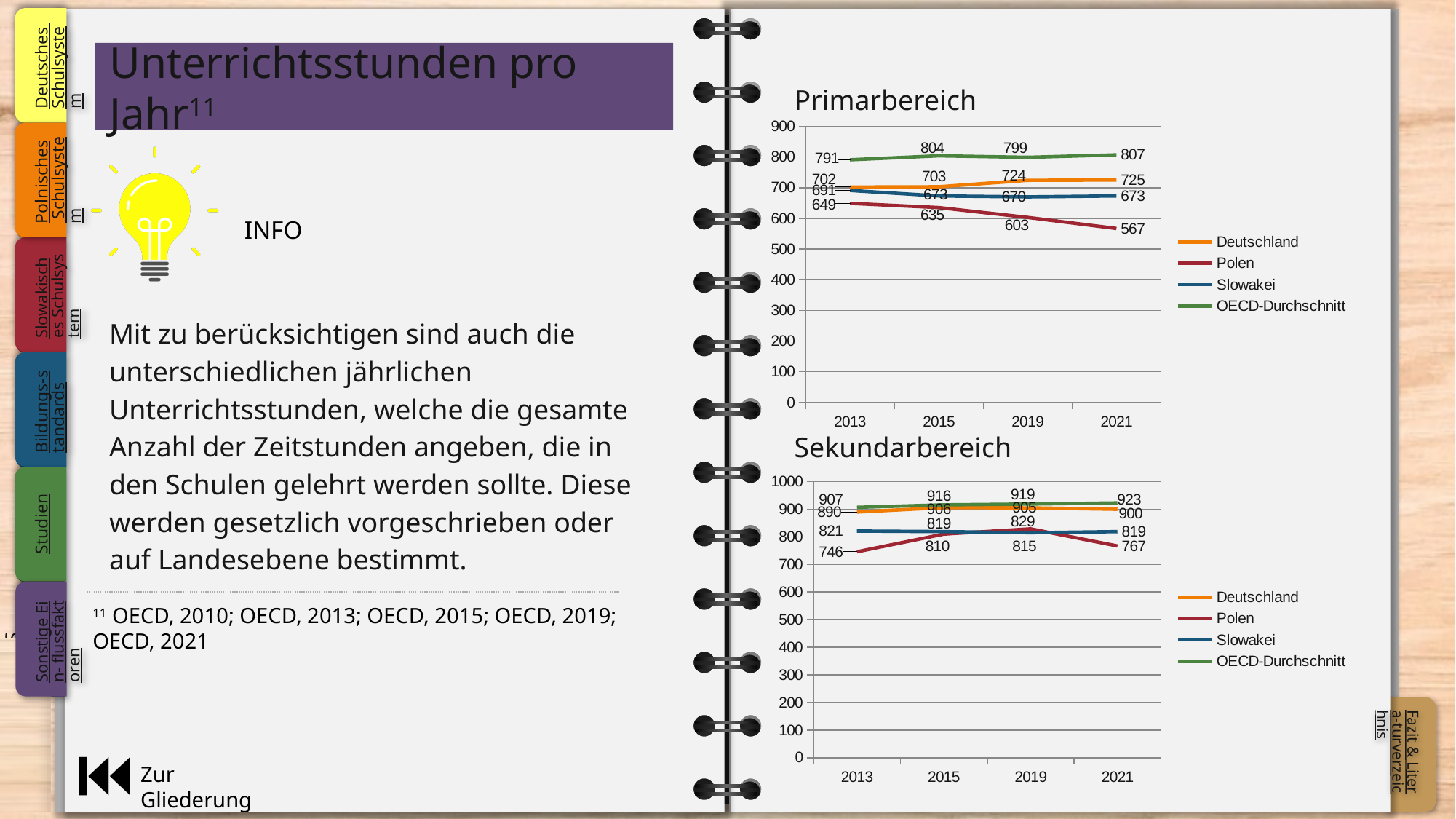
In the Sekundarbereich chart, what is the value for Polen in 2019? 829 In the Primarbereich chart, do the values for Polen rise or fall from 2013 to 2021? fall In the Primarbereich chart, what is the value for Polen in 2021? 567 In the Primarbereich chart, which series has the lowest value in 2021? Polen In the Primarbereich chart, what is the difference between the OECD-Durchschnitt and Deutschland values in 2021? 82 In the Primarbereich chart, what is the value for OECD-Durchschnitt in 2015? 804 In the Sekundarbereich chart, which series has the highest value in 2021? OECD-Durchschnitt What kind of chart is the Primarbereich chart? line chart In the Primarbereich chart, is the value for Deutschland in 2019 greater or less than the value for Slowakei in 2019? greater In the Sekundarbereich chart, what is the difference between the Slowakei and Polen values in 2013? 75 How many series does the legend of the Sekundarbereich chart list? 4 In the Sekundarbereich chart, what is the value for Deutschland in 2013? 890